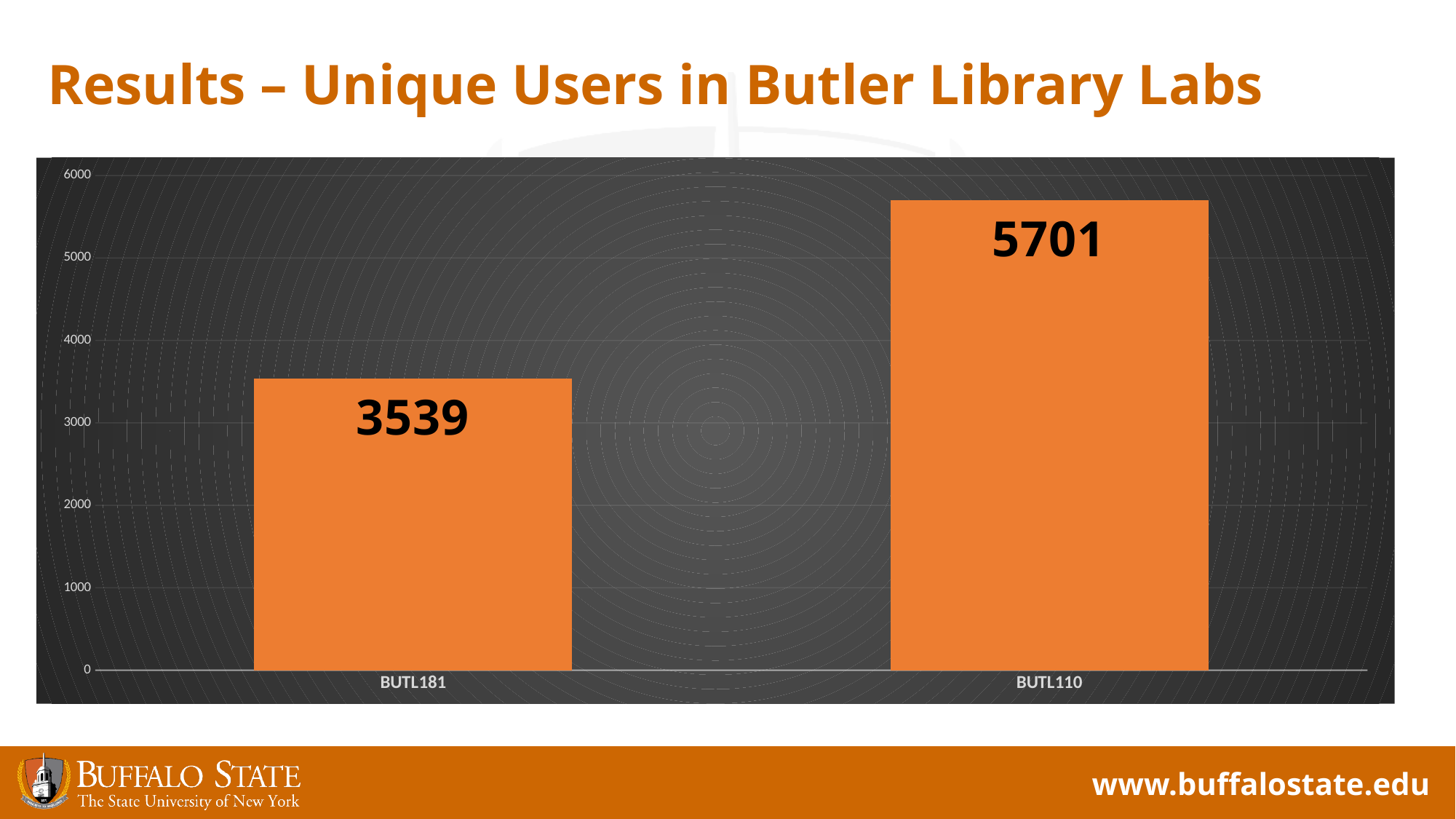
Is the value for BUTL181 greater or less than 4000? less How many categories are shown on the x axis? 2 What is the title of the slide? Results – Unique Users in Butler Library Labs What is the difference between the values for BUTL110 and BUTL181? 2162 What colour are the bars in the chart? orange Is the value for BUTL110 greater or less than 5000? greater What is the value for BUTL110? 5701 What kind of chart is shown on the slide? bar chart What is the value for BUTL181? 3539 Which is larger, the value for BUTL181 or the value for BUTL110? BUTL110 Which category has the lowest value? BUTL181 Which category has the highest value? BUTL110